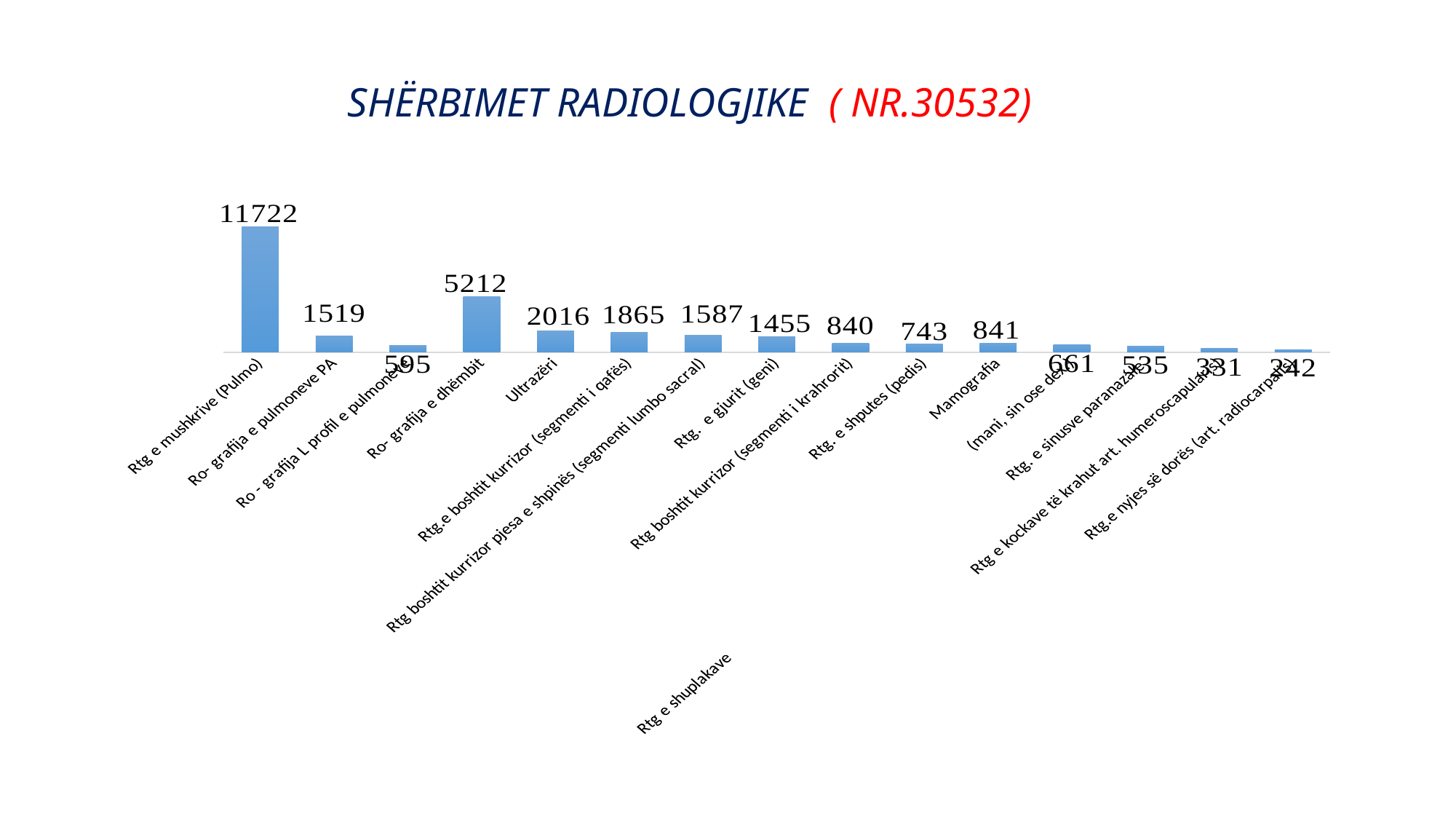
What is the value for Ultrazëri? 2016 What type of chart is shown on the slide? Bar chart What is the value for Ro- grafija e dhëmbit? 5212 What is the value for Rtg. e shputes (pedis)? 743 How many categories are shown in the chart? 15 Which category has the highest value? Rtg e mushkrive (Pulmo) What is the difference between the values for Ro- grafija e pulmoneve PA and Ro - grafija L profil e pulmoneve? 924 Which category has the lowest value? Rtg.e nyjes së dorës (art. radiocarpalis) What is the difference between the values for Rtg e mushkrive (Pulmo) and Ro- grafija e dhëmbit? 6510 What is the value for Mamografia? 841 Which is larger, the value for Ultrazëri or the value for Rtg. e gjurit (geni)? Ultrazëri What is the value for Rtg e mushkrive (Pulmo)? 11722